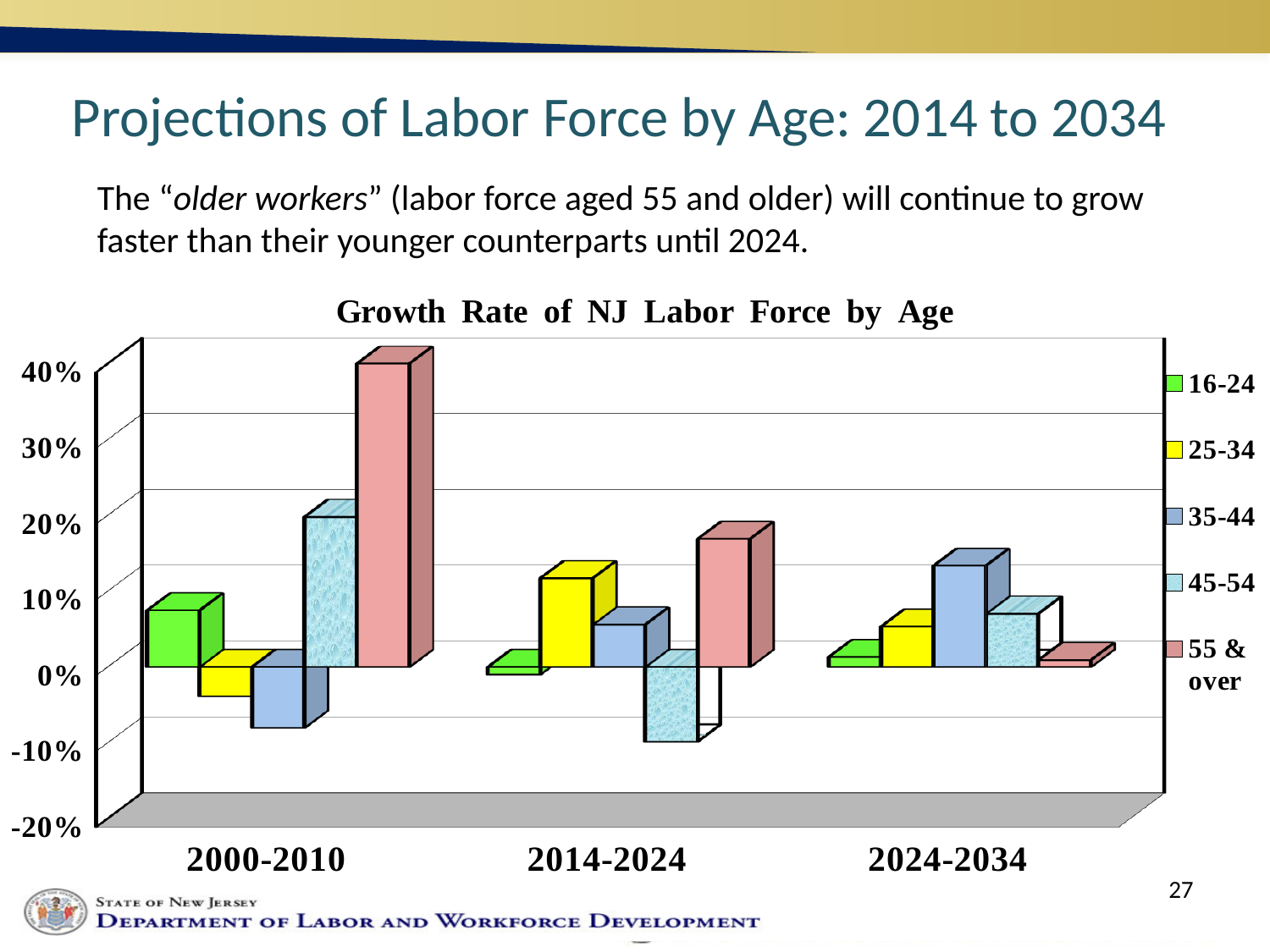
Which age group has the lowest growth rate in the 2014-2024 period? 45-54 Which age group has the highest growth rate in the 2014-2024 period? 55 & over How many age groups does the legend list? 5 How many time periods are shown on the x axis? 3 Which age group has the highest growth rate in the 2024-2034 period? 35-44 What kind of chart is shown on the slide? Bar chart What is the title of the chart? Growth Rate of NJ Labor Force by Age Is the growth rate for 55 & over in 2000-2010 greater or less than 30%? greater Which age group has the highest growth rate in the 2000-2010 period? 55 & over Does the growth rate for the 55 & over group rise or fall across the three periods from 2000-2010 to 2024-2034? Fall Which age group has the lowest growth rate in the 2000-2010 period? 35-44 Is the growth rate for 45-54 in 2014-2024 greater or less than 0%? less